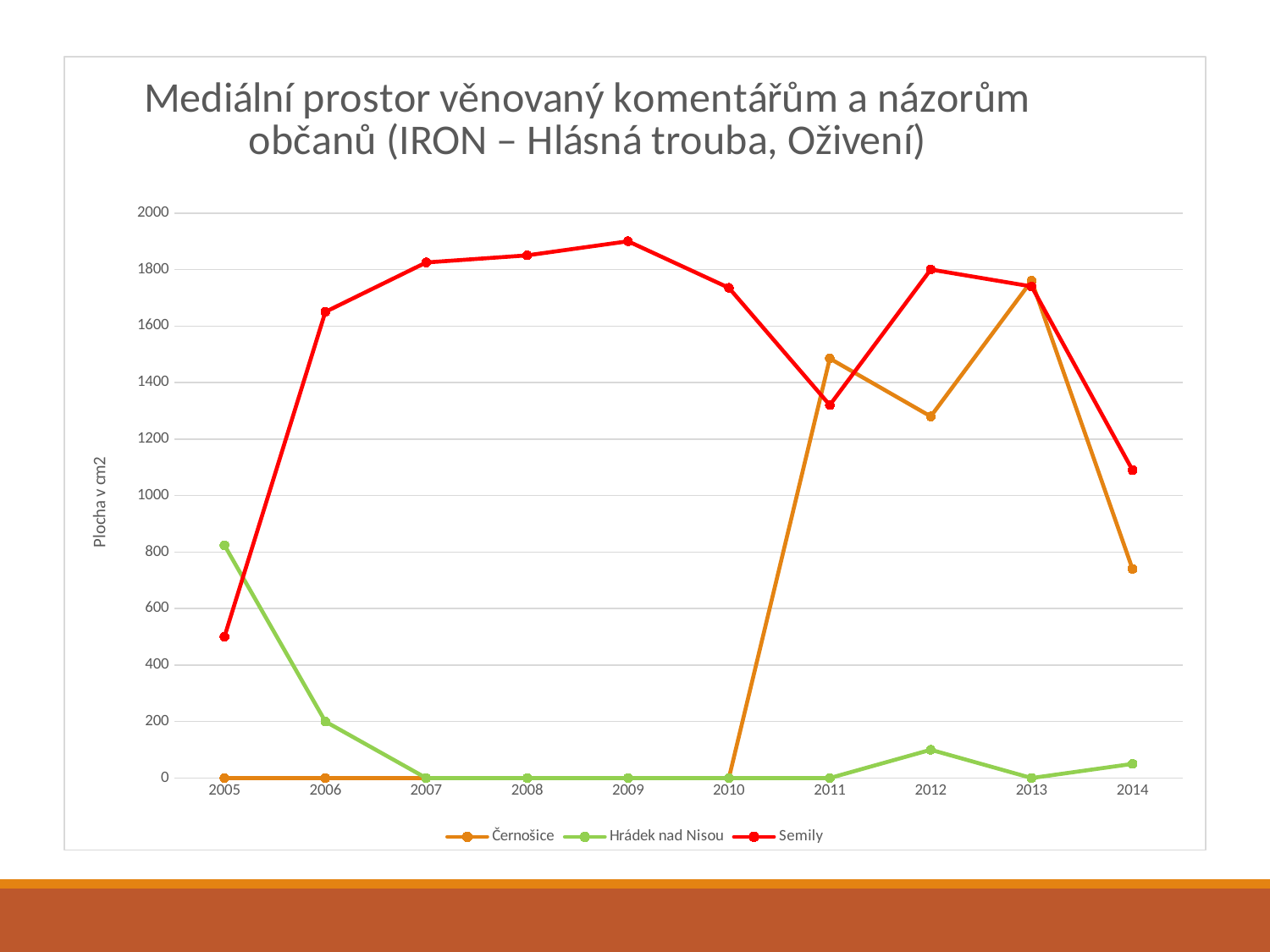
How many series does the legend list? 3 Is the value for Semily in 2009 greater or less than 1800? greater Is the value for Černošice in 2014 greater or less than 800? less In which year does Semily reach its highest value? 2009 Does the value for Hrádek nad Nisou rise or fall from 2005 to 2007? fall What is the value for Hrádek nad Nisou in 2006? 200 In 2011, which series has the higher value, Černošice or Semily? Černošice What is the value for Černošice in 2008? 0 What kind of chart is shown on the slide? line chart Is the value for Semily in 2005 greater or less than 600? less In which year does Semily have its lowest value? 2005 How many years are plotted along the x axis? 10